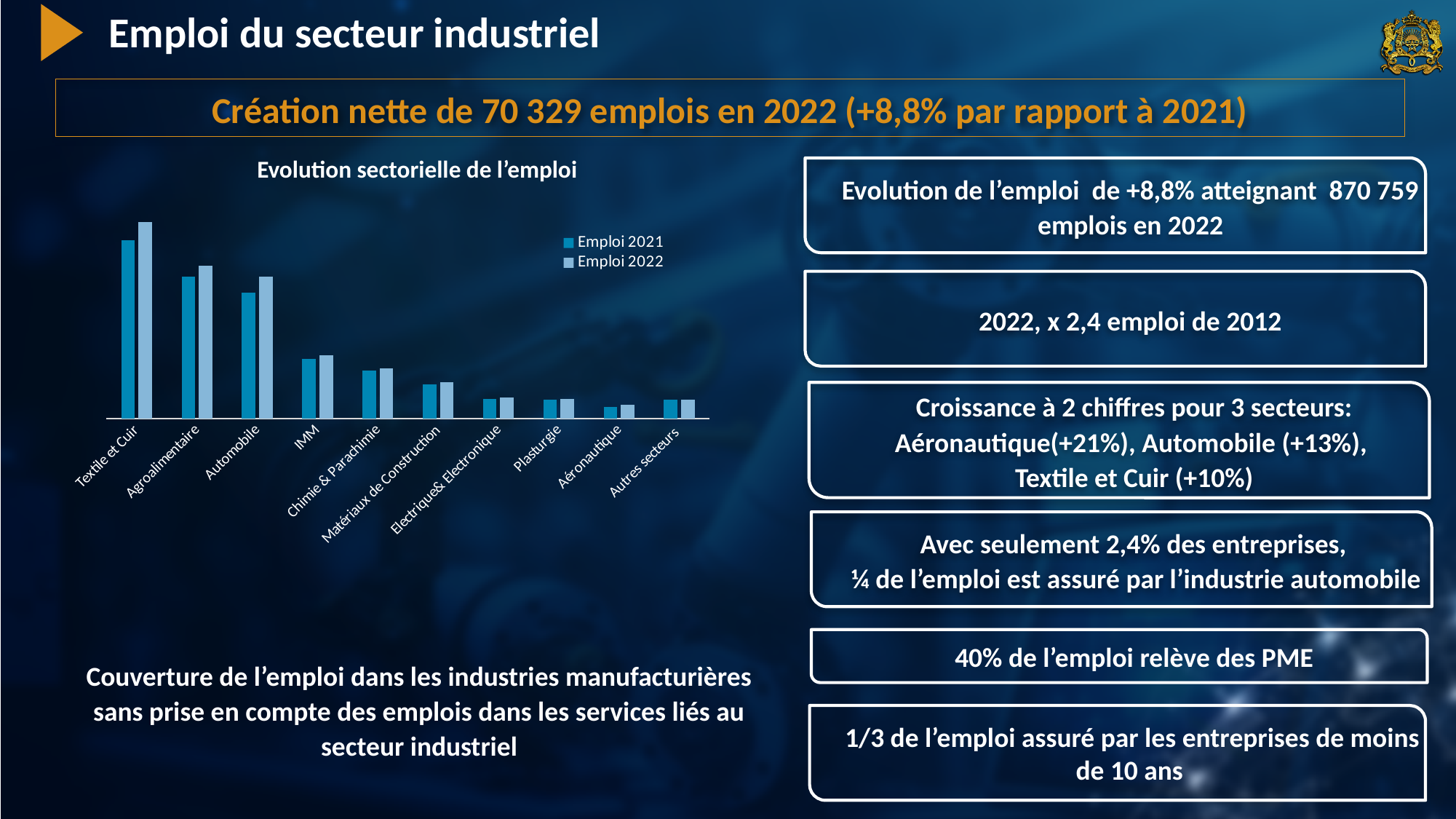
Which sector has the highest employment in 2022 according to the chart? Textile et Cuir In 2021, which sector has more employment: Agroalimentaire or Automobile? Agroalimentaire For Textile et Cuir, which is larger: Emploi 2021 or Emploi 2022? Emploi 2022 Do the bars in the chart generally rise or fall from left to right across the sectors? fall How many series does the legend of the chart list? 2 Which sector has the highest employment in 2021 according to the chart? Textile et Cuir What are the two series named in the chart legend? Emploi 2021 and Emploi 2022 What kind of chart is shown under the title 'Evolution sectorielle de l'emploi'? bar chart In 2022, which sector has more employment: IMM or Chimie & Parachimie? IMM Which sector has the lowest Emploi 2021 bar in the chart? Aéronautique What is the title of the chart on the slide? Evolution sectorielle de l'emploi How many sectors (categories) are shown on the x axis of the chart? 10